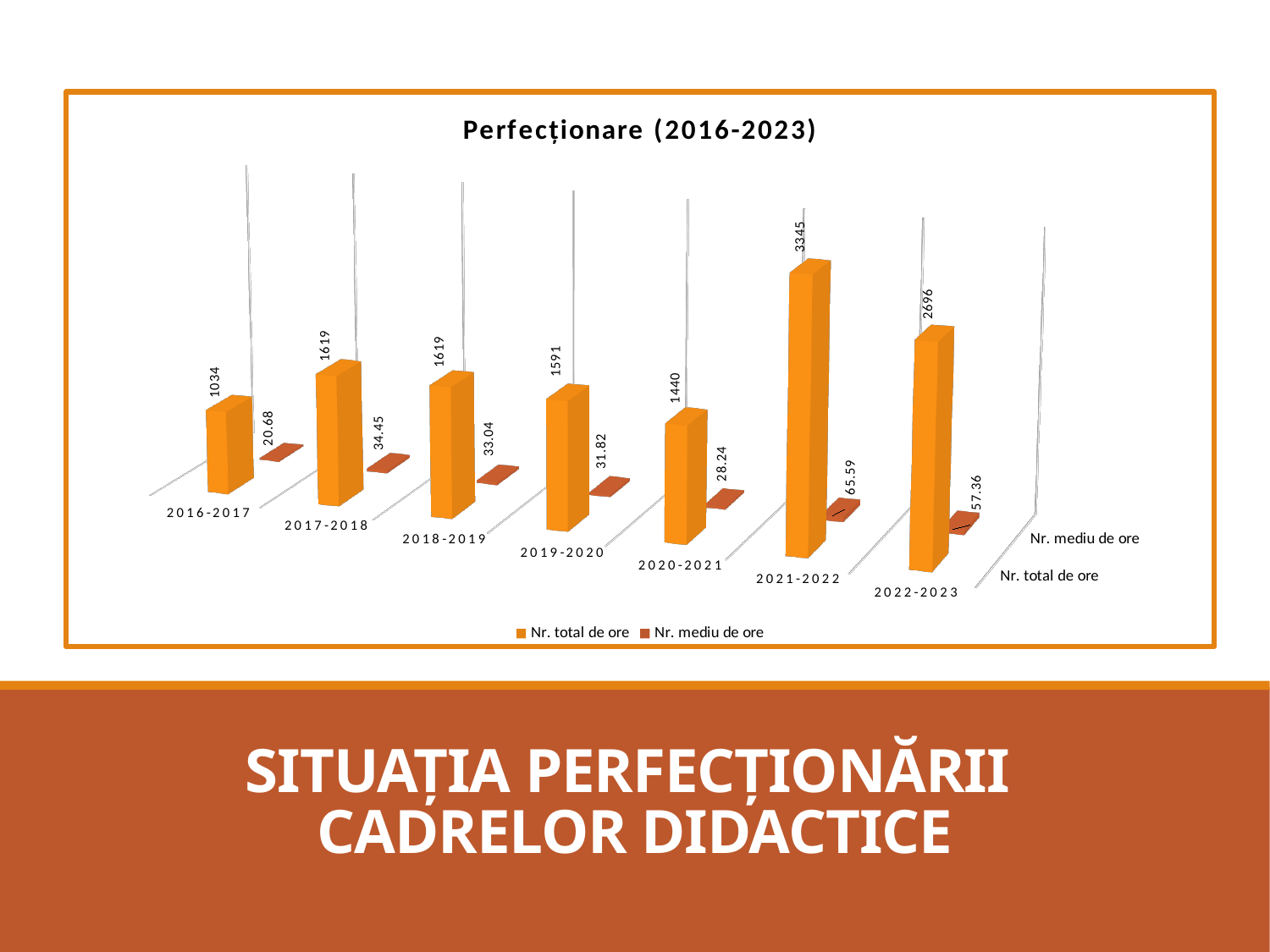
Which year has the highest Nr. total de ore? 2021-2022 How many series does the legend list? 2 What is the value of Nr. mediu de ore for 2022-2023? 57.36 Which is larger, Nr. total de ore for 2019-2020 or for 2020-2021? 2019-2020 How many academic years are shown on the chart? 7 What is the difference in Nr. total de ore between 2021-2022 and 2022-2023? 649 What is the title of the chart? Perfecționare (2016-2023) What kind of chart is shown on the slide? Bar chart What is the value of Nr. total de ore for 2020-2021? 1440 What is the value of Nr. total de ore for 2021-2022? 3345 What is the value of Nr. mediu de ore for 2016-2017? 20.68 Which year has the lowest Nr. mediu de ore? 2016-2017